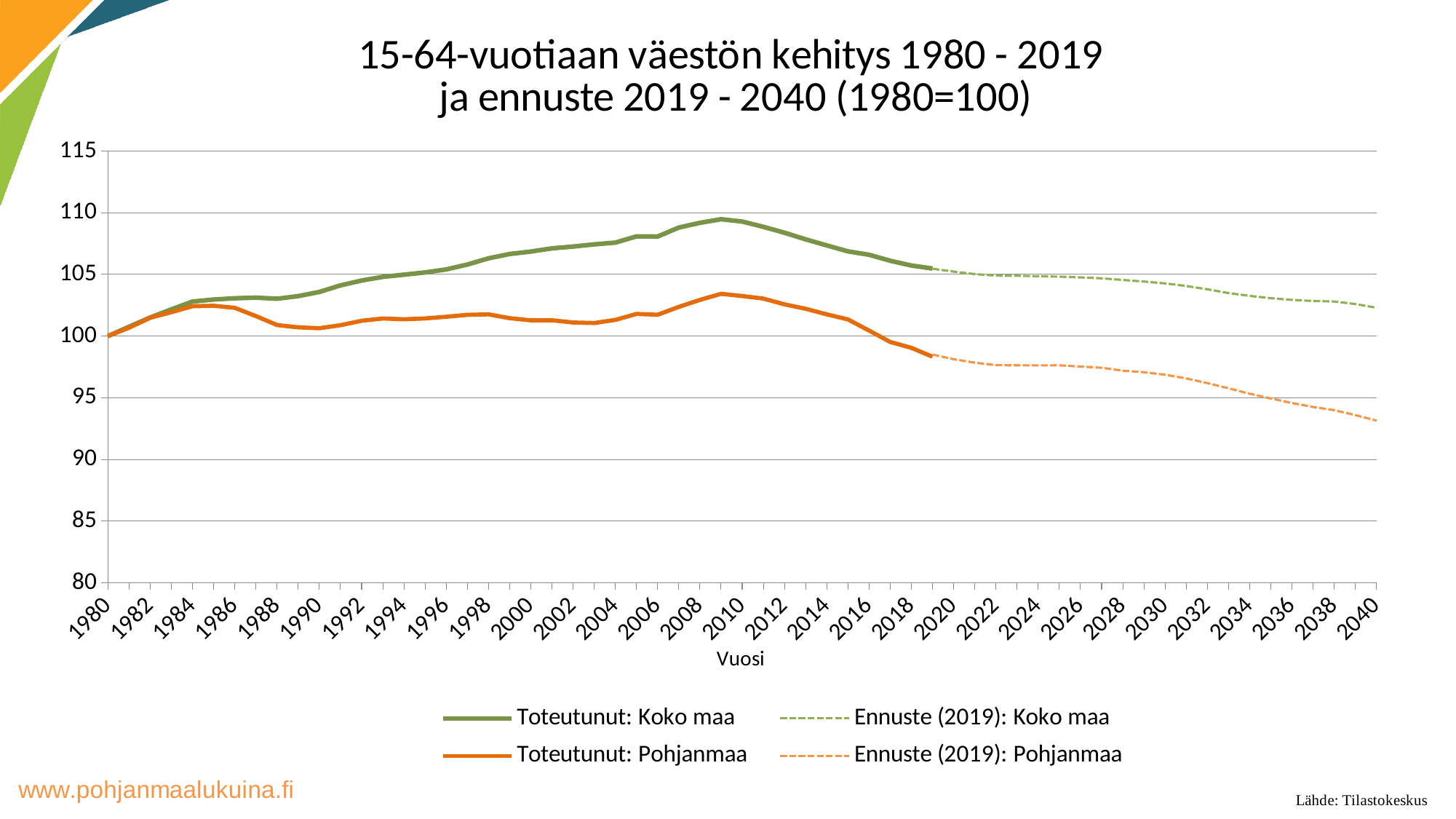
What is the value of Toteutunut: Koko maa in 1980? 100 What kind of chart is shown on the slide? line chart In 2010, which is larger: Toteutunut: Koko maa or Toteutunut: Pohjanmaa? Toteutunut: Koko maa Does the Ennuste (2019): Pohjanmaa line rise or fall from 2020 to 2040? fall What is the value of Toteutunut: Pohjanmaa in 1980? 100 What is the title of the x axis? Vuosi Does the Toteutunut: Koko maa line rise or fall from 1980 to 2008? rise Is the value for Ennuste (2019): Koko maa in 2040 greater or less than 100? greater How many series does the legend list? 4 Is the value for Toteutunut: Koko maa in 2010 greater or less than 105? greater Is the value for Toteutunut: Pohjanmaa in 2018 greater or less than 100? less